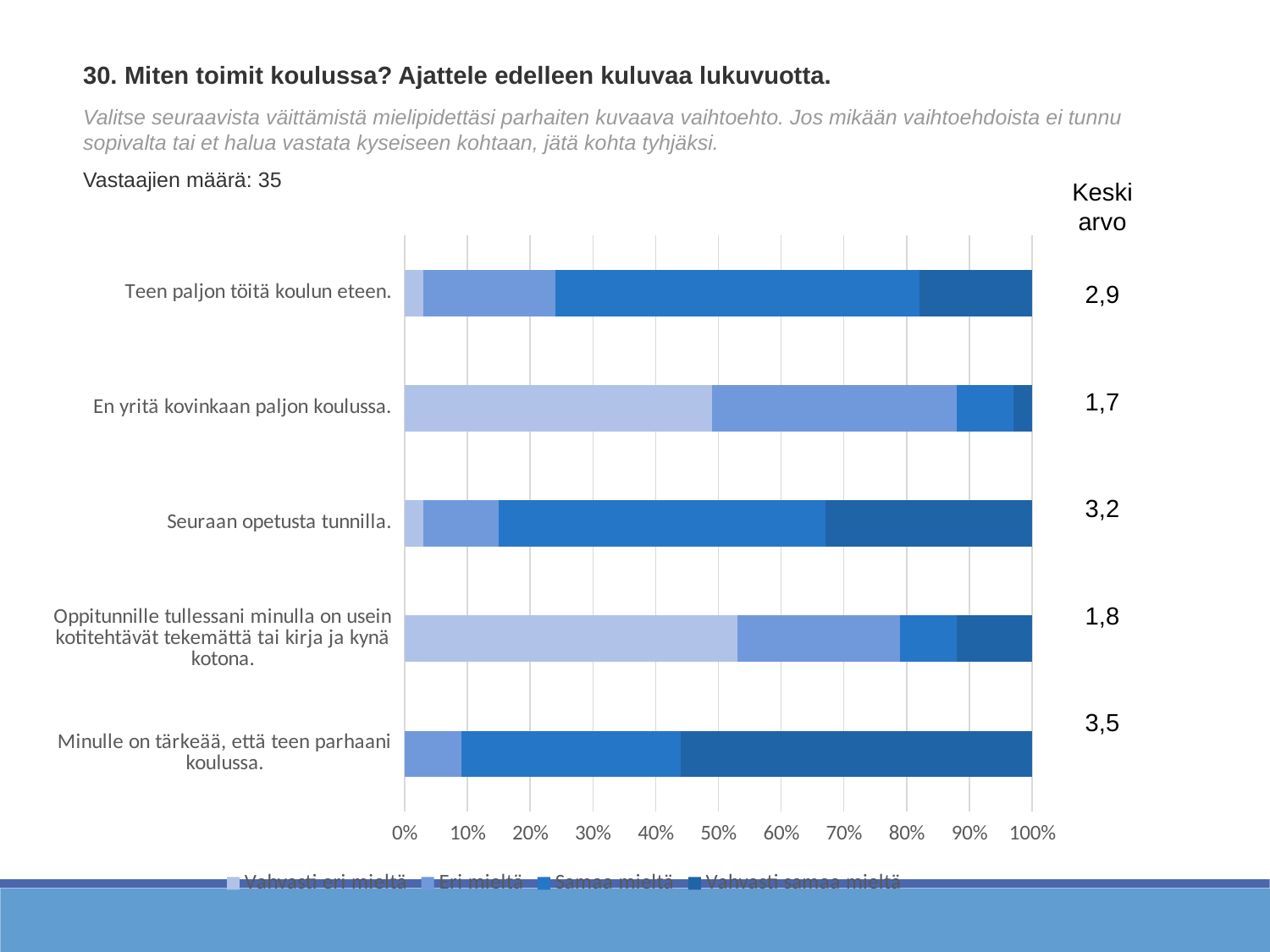
What is the Keskiarvo (mean) value shown for "Teen paljon töitä koulun eteen."? 2,9 Is the "Vahvasti eri mieltä" share for "Oppitunnille tullessani minulla on usein kotitehtävät tekemättä tai kirja ja kynä kotona." greater or less than 40%? greater What is the difference between the Keskiarvo values of "Minulle on tärkeää, että teen parhaani koulussa." and "Seuraan opetusta tunnilla."? 0,3 What is the Keskiarvo value shown for "En yritä kovinkaan paljon koulussa."? 1,7 What is the Keskiarvo value shown for "Minulle on tärkeää, että teen parhaani koulussa."? 3,5 Which has a higher Keskiarvo value: "Seuraan opetusta tunnilla." or "Teen paljon töitä koulun eteen."? Seuraan opetusta tunnilla. How many respondents (Vastaajien määrä) are reported on the slide? 35 How many series does the legend list? 4 Which statement has the lowest Keskiarvo value? En yritä kovinkaan paljon koulussa. Which statement has the highest Keskiarvo value? Minulle on tärkeää, että teen parhaani koulussa. What kind of chart is shown on the slide? Stacked bar chart How many statements (categories) are plotted in the chart? 5